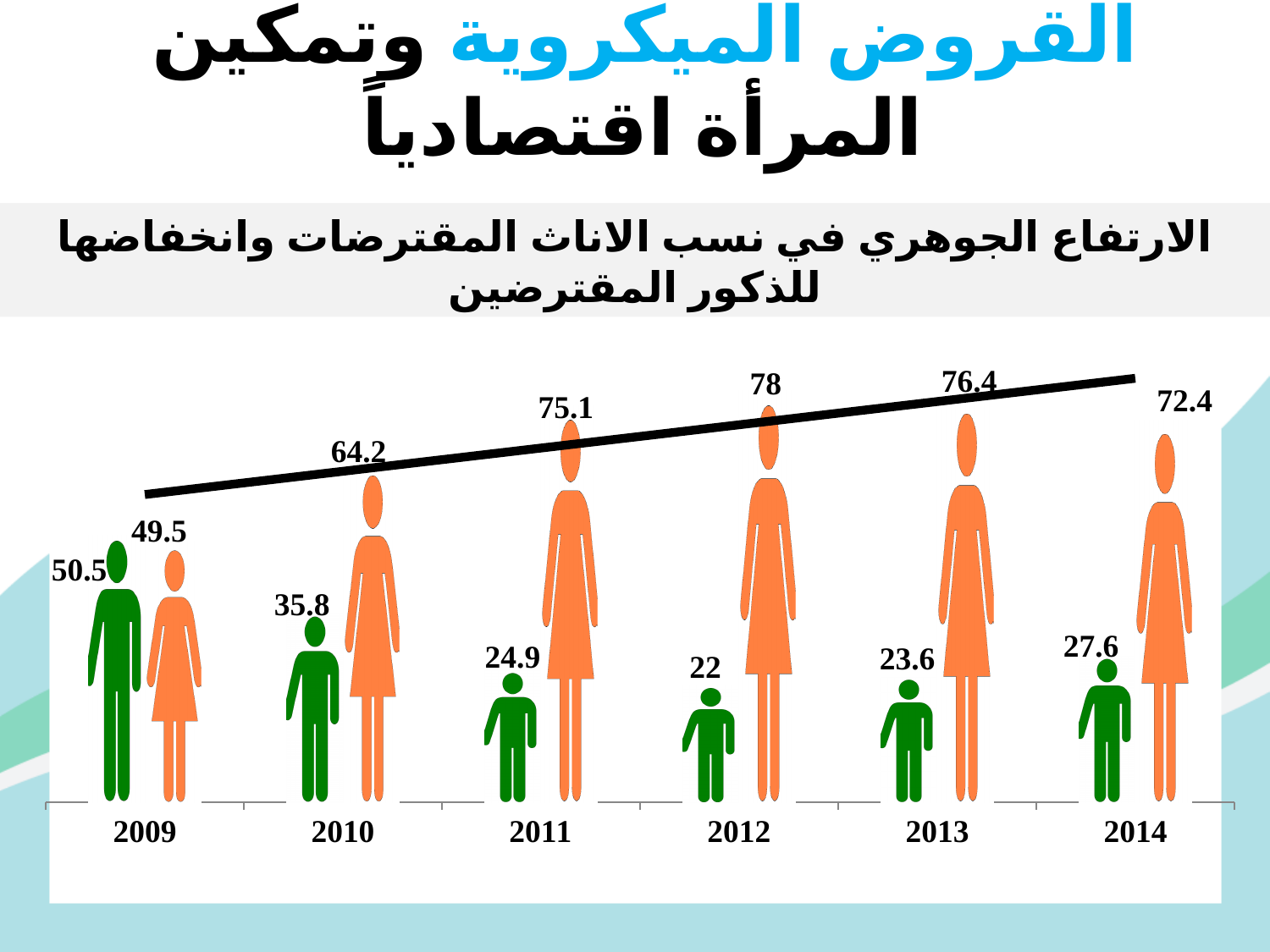
What is the value shown for the male (green) figure in 2013? 23.6 What is the difference between the male values in 2009 and 2010? 14.7 How does the female (orange) value change from 2009 to 2012? It rises What is the value shown for the female (orange) figure in 2012? 78 What is the value shown for the female (orange) figure in 2014? 72.4 What is the value shown for the male (green) figure in 2009? 50.5 What colour are the male figures in the chart? Green How many years are shown on the x axis? 6 In which year is the male (green) value the lowest? 2012 Which is larger in 2009, the male (green) value or the female (orange) value? male (green), 50.5 What is the difference between the female value and the male value in 2011? 50.2 In which year is the female (orange) value the highest? 2012